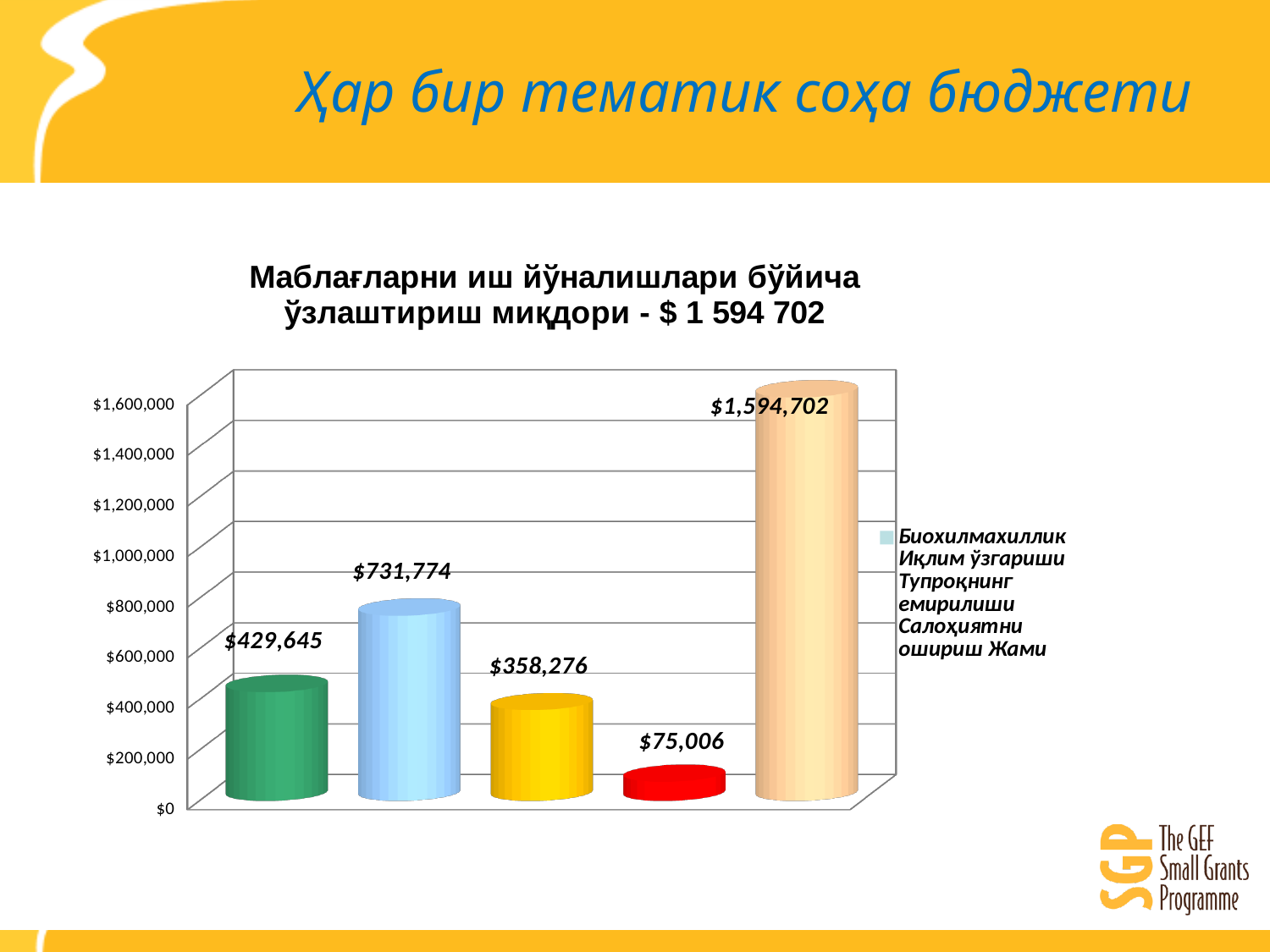
What is the difference between the yellow bar ($358,276) and the red bar ($75,006)? $283,270 What type of chart is shown on the slide? Bar chart How many bars are plotted in the chart? 5 Which bar has the lowest value? The red bar ($75,006) Which is larger, the value of the green bar or the value of the yellow bar? The green bar ($429,645) Which bar has the highest value? The peach-coloured bar on the far right ($1,594,702) What is the value shown on the light blue bar (second from the left)? $731,774 What is the difference between the light blue bar ($731,774) and the green bar ($429,645)? $302,129 What is the value shown on the red bar (fourth from the left)? $75,006 What is the value shown on the tallest bar (the peach-coloured bar on the far right)? $1,594,702 What is the value shown on the yellow bar (third from the left)? $358,276 What is the value shown on the green bar (first from the left)? $429,645